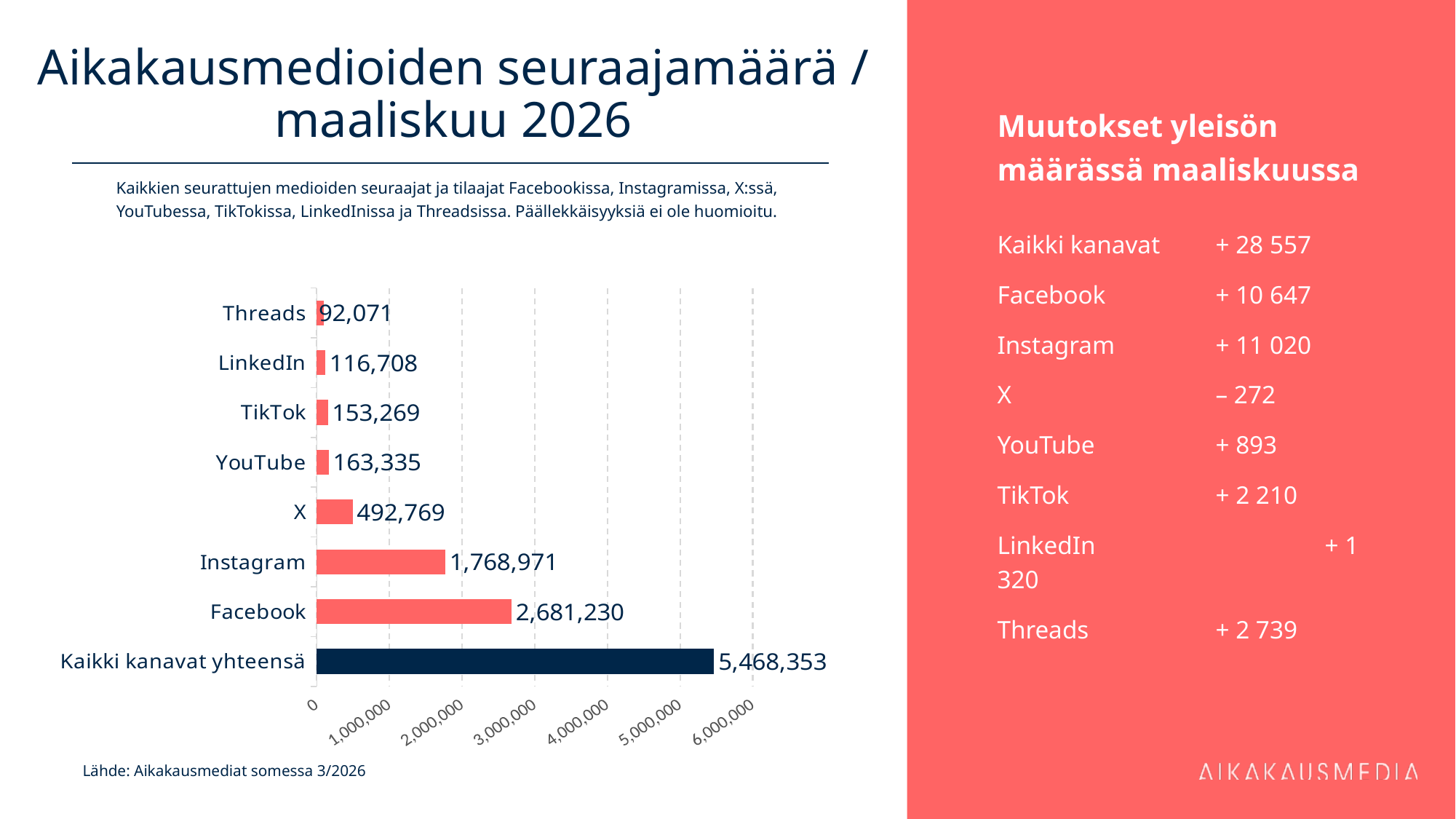
What is the difference between the YouTube and TikTok values? 10,066 Which individual platform (excluding the total bar) has the highest follower count? Facebook What is the value shown for 'Kaikki kanavat yhteensä'? 5,468,353 How many categories (bars) are shown in the chart? 8 Which is larger, the value for X or the value for YouTube? X What type of chart is shown on the slide? Bar chart Is the value for Facebook greater or less than 2,000,000? greater What value is shown for Instagram? 1,768,971 Which category has the lowest value in the chart? Threads What is the value for Threads? 92,071 What is the difference between the Facebook and Instagram values? 912,259 What is the follower count shown for Facebook? 2,681,230